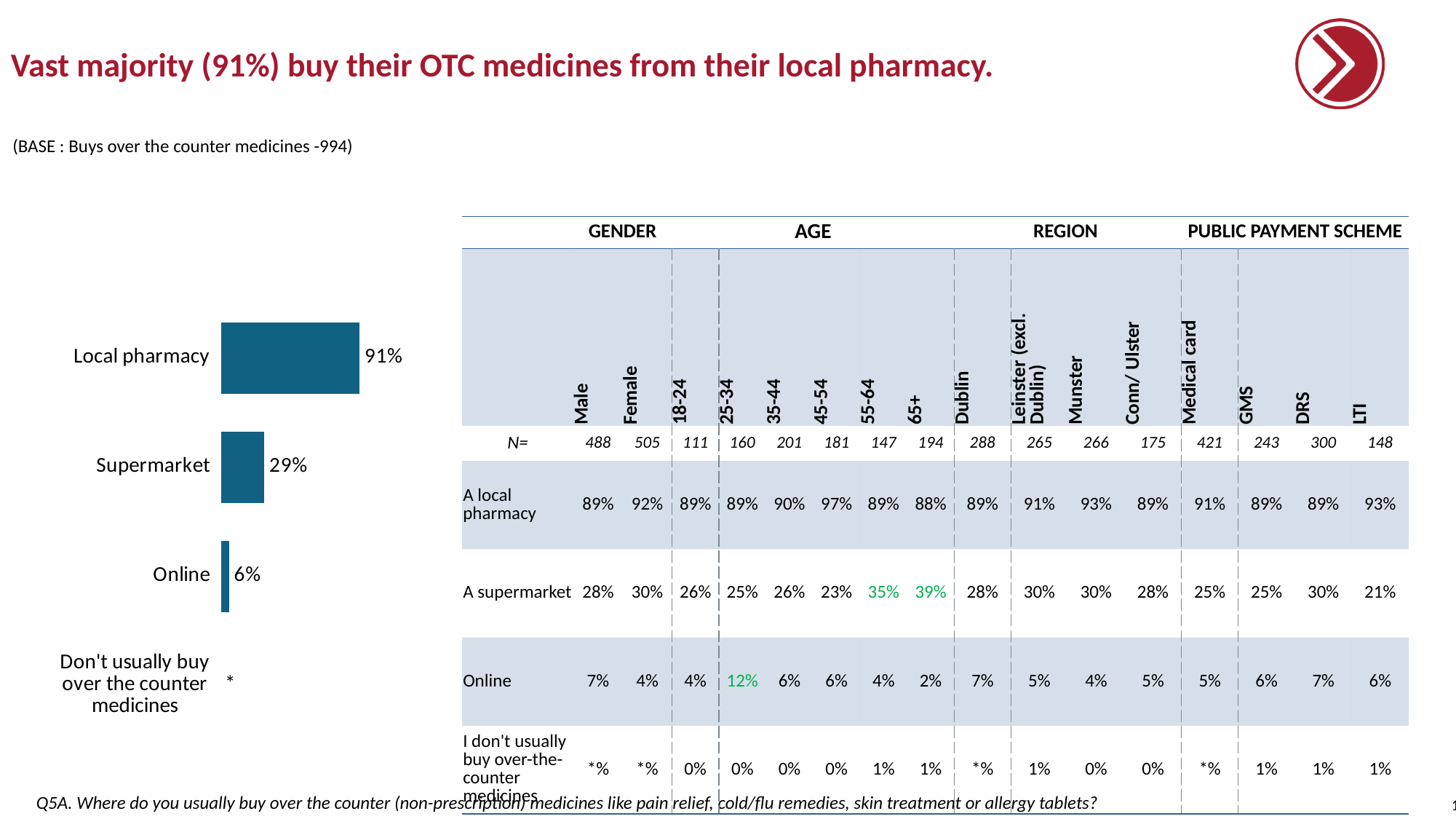
What is the value shown for Online in the bar chart? 6% What label is shown for the 'Don't usually buy over the counter medicines' bar in the chart? * What is the base size stated for the chart? 994 How many categories are shown in the bar chart? 4 Which is larger in the bar chart, Supermarket or Online? Supermarket Which category has the lowest value among those with a printed percentage in the bar chart? Online What is the difference between the Supermarket and Online values in the bar chart? 23% Which category has the highest value in the bar chart? Local pharmacy What kind of chart is used to show where people buy OTC medicines? Bar chart What is the value shown for Supermarket in the bar chart? 29% What is the difference between the Local pharmacy and Supermarket values in the bar chart? 62% What percentage of respondents buy their OTC medicines from a local pharmacy? 91%